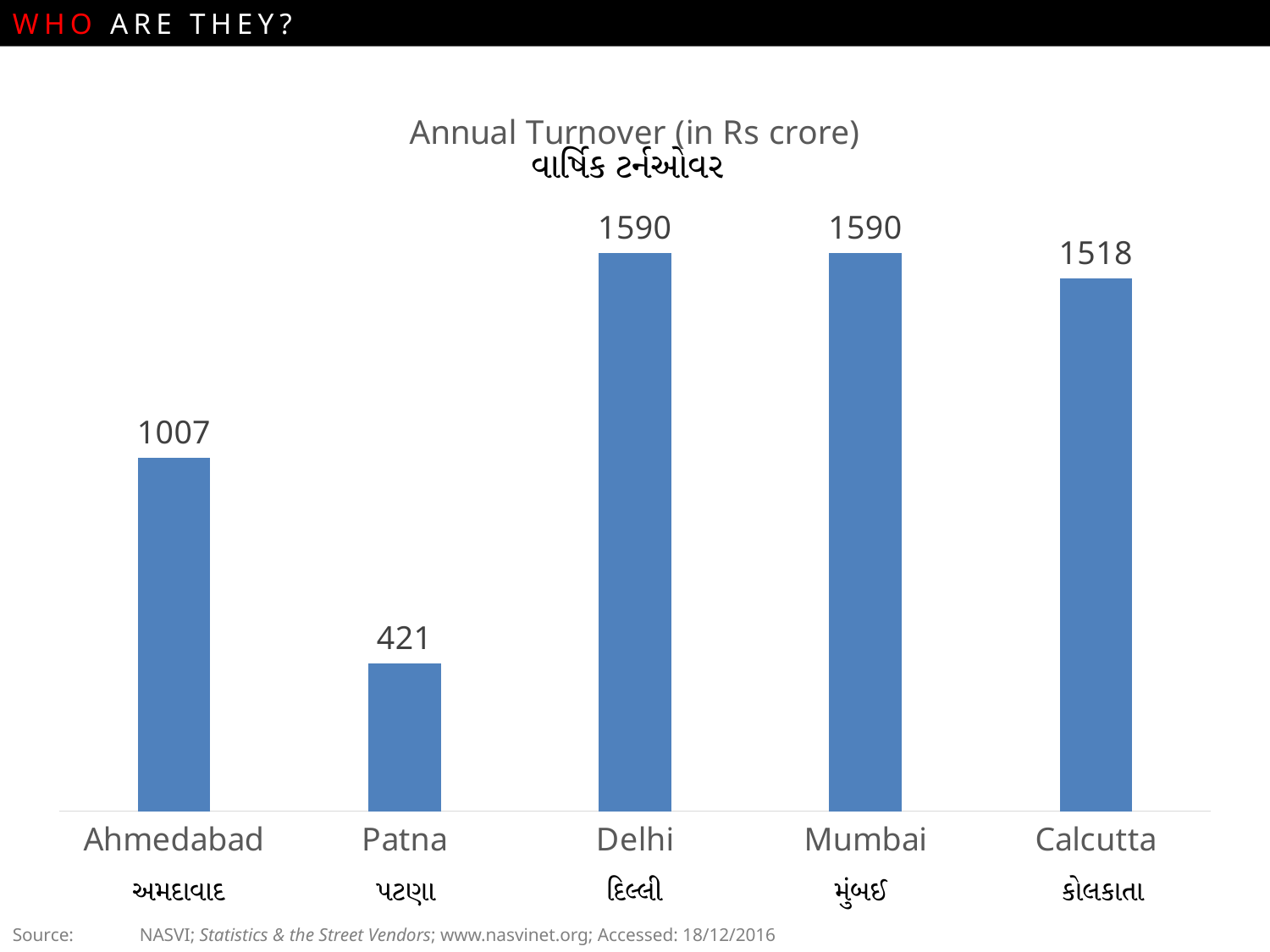
What is the difference in annual turnover between Delhi and Patna? 1169 What is the difference in annual turnover between Mumbai and Calcutta? 72 What type of chart is shown on the slide? Bar chart What is the title of the chart? Annual Turnover (in Rs crore) How many cities are shown in the chart? 5 What is the annual turnover for Ahmedabad? 1007 What is the annual turnover for Patna? 421 Which has a higher annual turnover, Ahmedabad or Calcutta? Calcutta What is the annual turnover for Calcutta? 1518 What is the annual turnover for Delhi? 1590 Which two cities share the same annual turnover of 1590? Delhi and Mumbai Which city has the lowest annual turnover? Patna